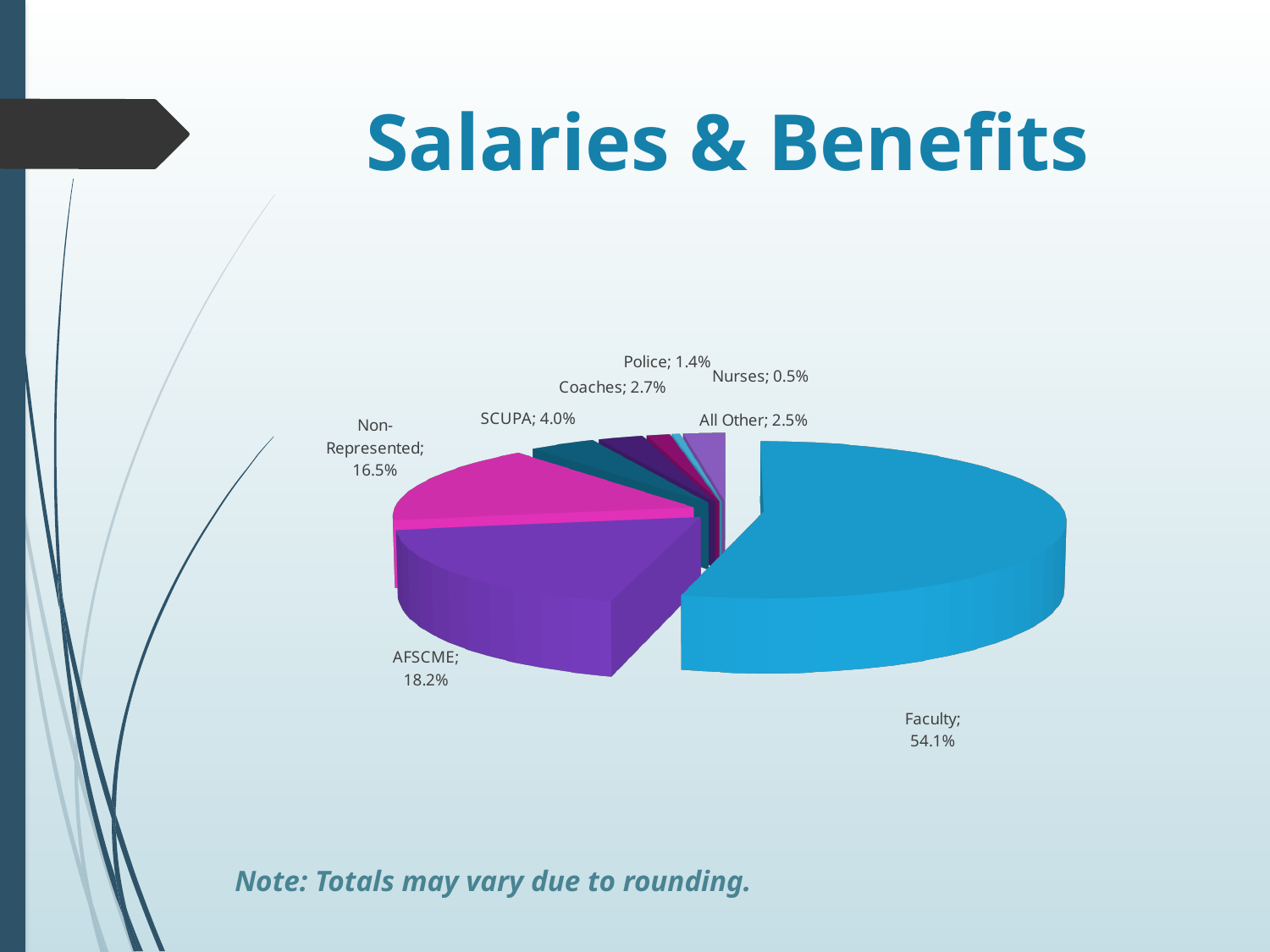
Which category has the smallest share of the pie? Nurses What percentage is shown for AFSCME? 18.2% Which category has the largest share of the pie? Faculty What type of chart is shown on the slide? Pie chart Which is larger, the share for Coaches or the share for Police? Coaches How many categories are shown in the pie chart? 8 What percentage is shown for Non-Represented? 16.5% What percentage is shown for Nurses? 0.5% What percentage is shown for SCUPA? 4.0% What is the title of the slide containing the chart? Salaries & Benefits What share of Salaries & Benefits goes to Faculty? 54.1% What is the difference in percentage points between AFSCME and Non-Represented? 1.7